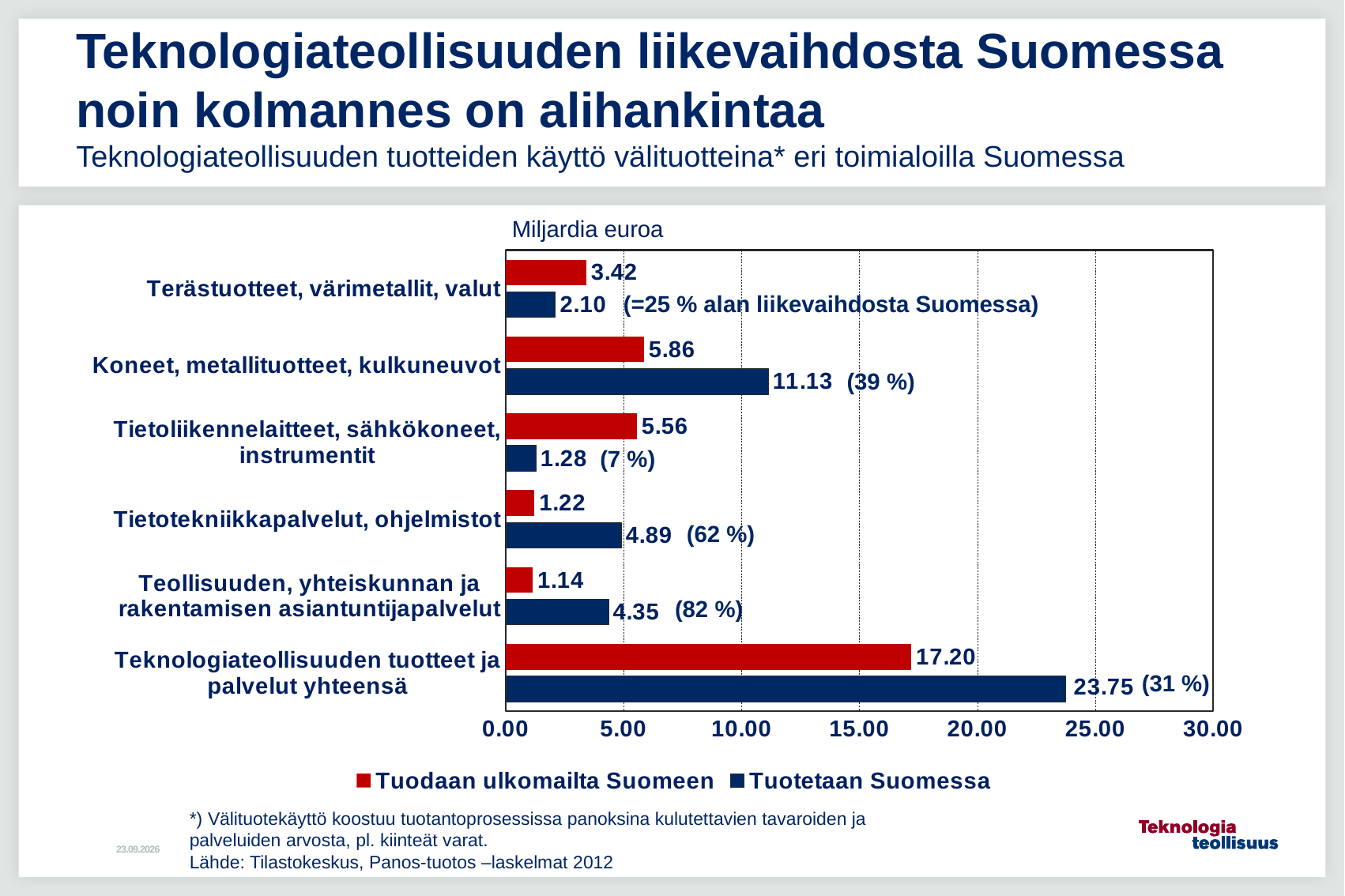
What unit is shown above the chart? Miljardia euroa Is the value of "Tuodaan ulkomailta Suomeen" for "Teknologiateollisuuden tuotteet ja palvelut yhteensä" greater or less than 15.00? greater How many categories are shown on the chart? 6 What is the value of "Tuotetaan Suomessa" for "Teknologiateollisuuden tuotteet ja palvelut yhteensä"? 23.75 Excluding the total row, which category has the highest value for "Tuotetaan Suomessa"? Koneet, metallituotteet, kulkuneuvot What kind of chart is shown on the slide? bar chart What is the value of "Tuodaan ulkomailta Suomeen" for "Koneet, metallituotteet, kulkuneuvot"? 5.86 How many series does the legend list? 2 What is the value of "Tuotetaan Suomessa" for "Tietotekniikkapalvelut, ohjelmistot"? 4.89 For "Tietoliikennelaitteet, sähkökoneet, instrumentit", which is larger: "Tuodaan ulkomailta Suomeen" or "Tuotetaan Suomessa"? Tuodaan ulkomailta Suomeen What is the difference between "Tuotetaan Suomessa" and "Tuodaan ulkomailta Suomeen" for "Koneet, metallituotteet, kulkuneuvot"? 5.27 Which category has the lowest value for "Tuodaan ulkomailta Suomeen"? Teollisuuden, yhteiskunnan ja rakentamisen asiantuntijapalvelut